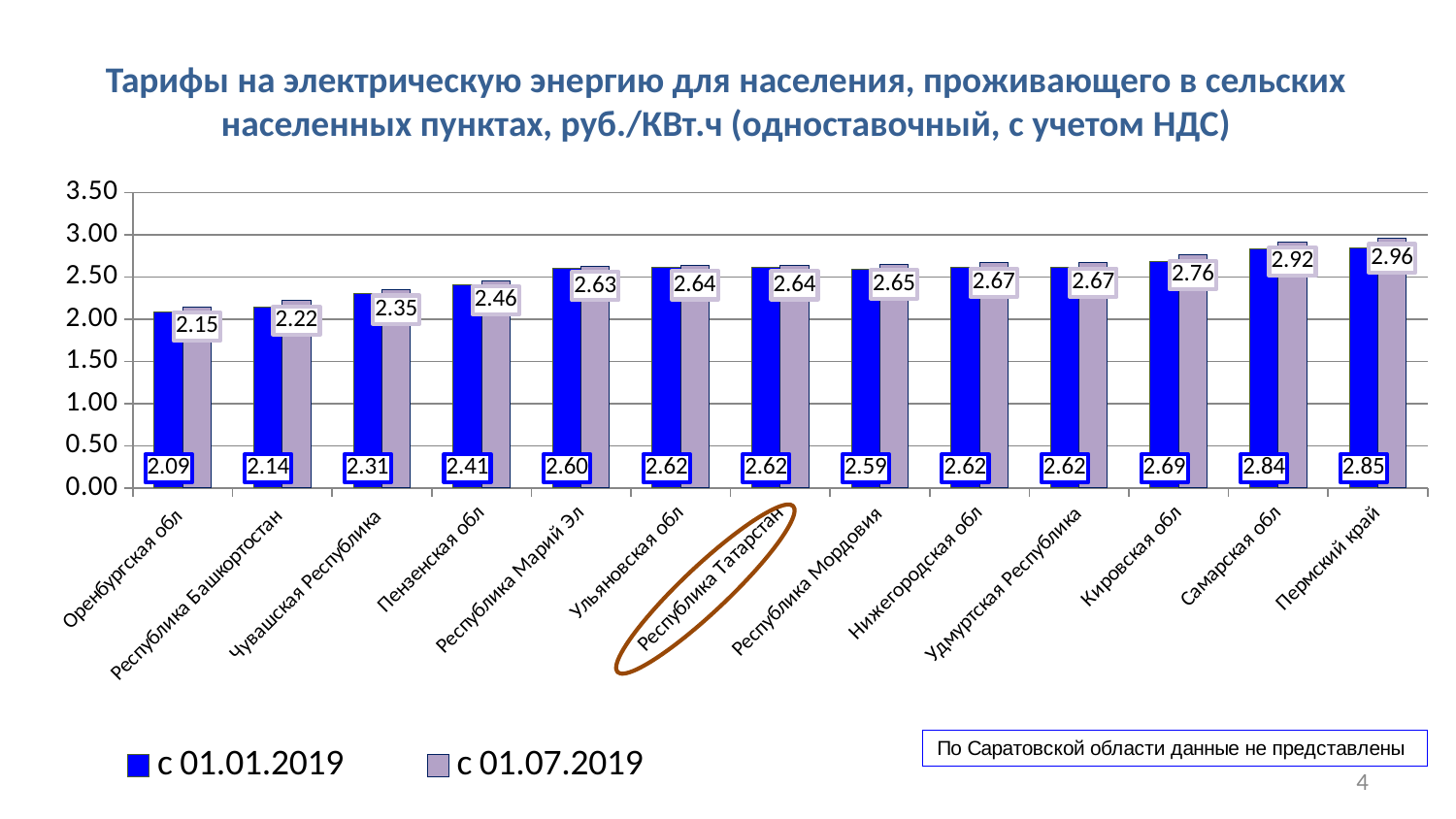
Which region is circled on the x axis of the chart? Республика Татарстан What is the difference between the 01.07.2019 and 01.01.2019 tariffs for Самарская обл? 0.08 How many regions are shown on the x axis? 13 Which region has the lowest tariff as of 01.01.2019? Оренбургская обл Which is larger: the 01.01.2019 tariff for Пензенская обл or for Чувашская Республика? Пензенская обл How many series does the legend list? 2 What is the tariff for Кировская обл as of 01.01.2019? 2.69 What is the tariff for Республика Мордовия as of 01.07.2019? 2.65 What type of chart is shown on the slide? bar chart Which region has the highest tariff as of 01.07.2019? Пермский край What is the tariff for Республика Татарстан as of 01.07.2019? 2.64 Do the 01.07.2019 tariffs generally rise or fall from left to right along the x axis? rise